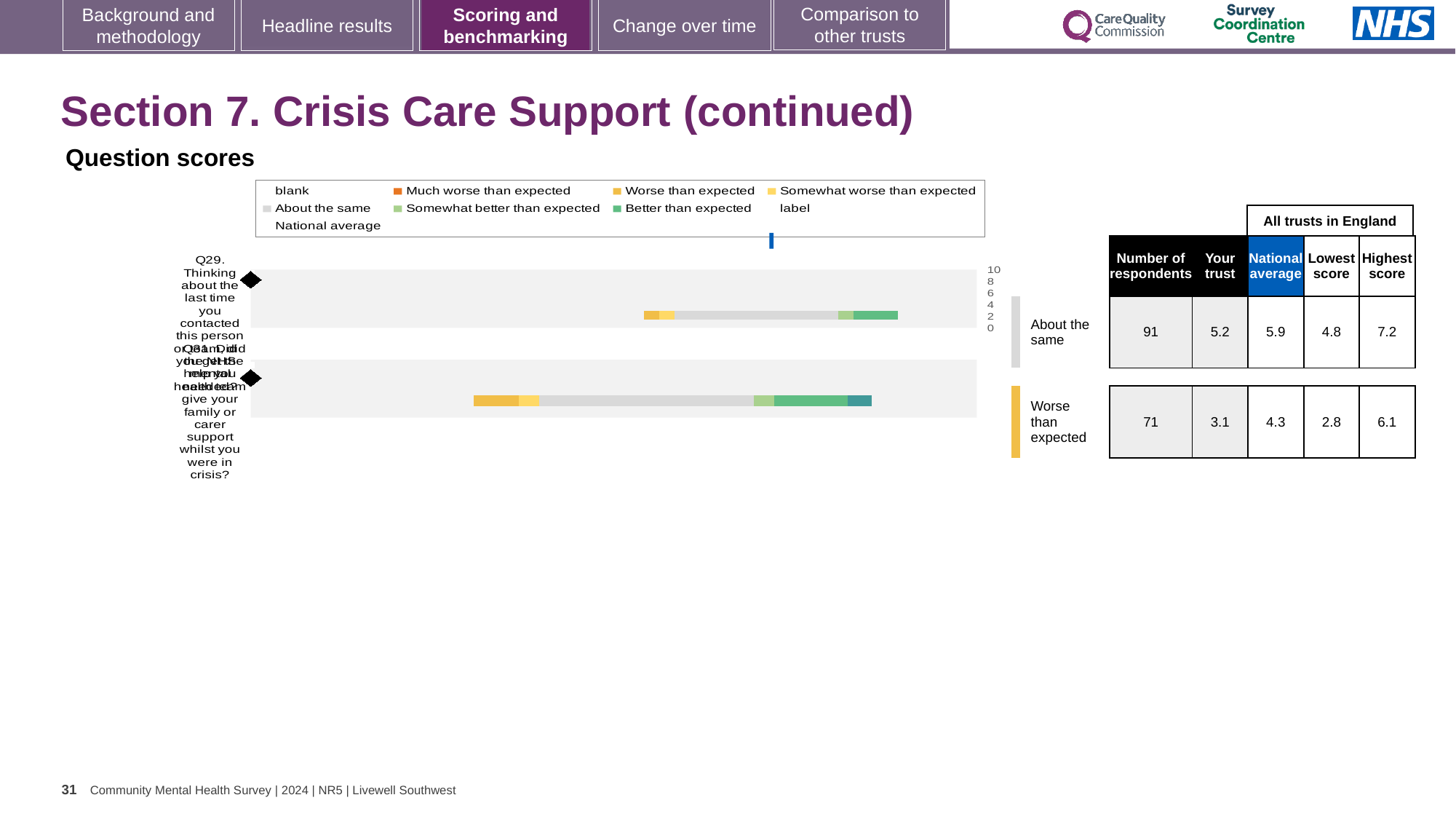
What kind of chart is used to show the question scores on this slide? bar chart How many questions are plotted in the question scores chart? 2 Which benchmark category is shown for Q29 in the question scores chart? About the same What is the difference between the national average and the trust's score for Q31? 1.2 Which benchmark category is shown for Q31 in the question scores chart? Worse than expected What is the number of respondents for Q31 in the table beside the chart? 71 What is the highest score among all trusts in England for Q31? 6.1 What is the national average for Q29 in the table beside the chart? 5.9 What is the 'Your trust' score for Q29 in the table beside the chart? 5.2 What is the difference between the highest and lowest scores for Q29? 2.4 Which question has the higher 'Your trust' score, Q29 or Q31? Q29 What is the 'Your trust' score for Q31 in the table beside the chart? 3.1